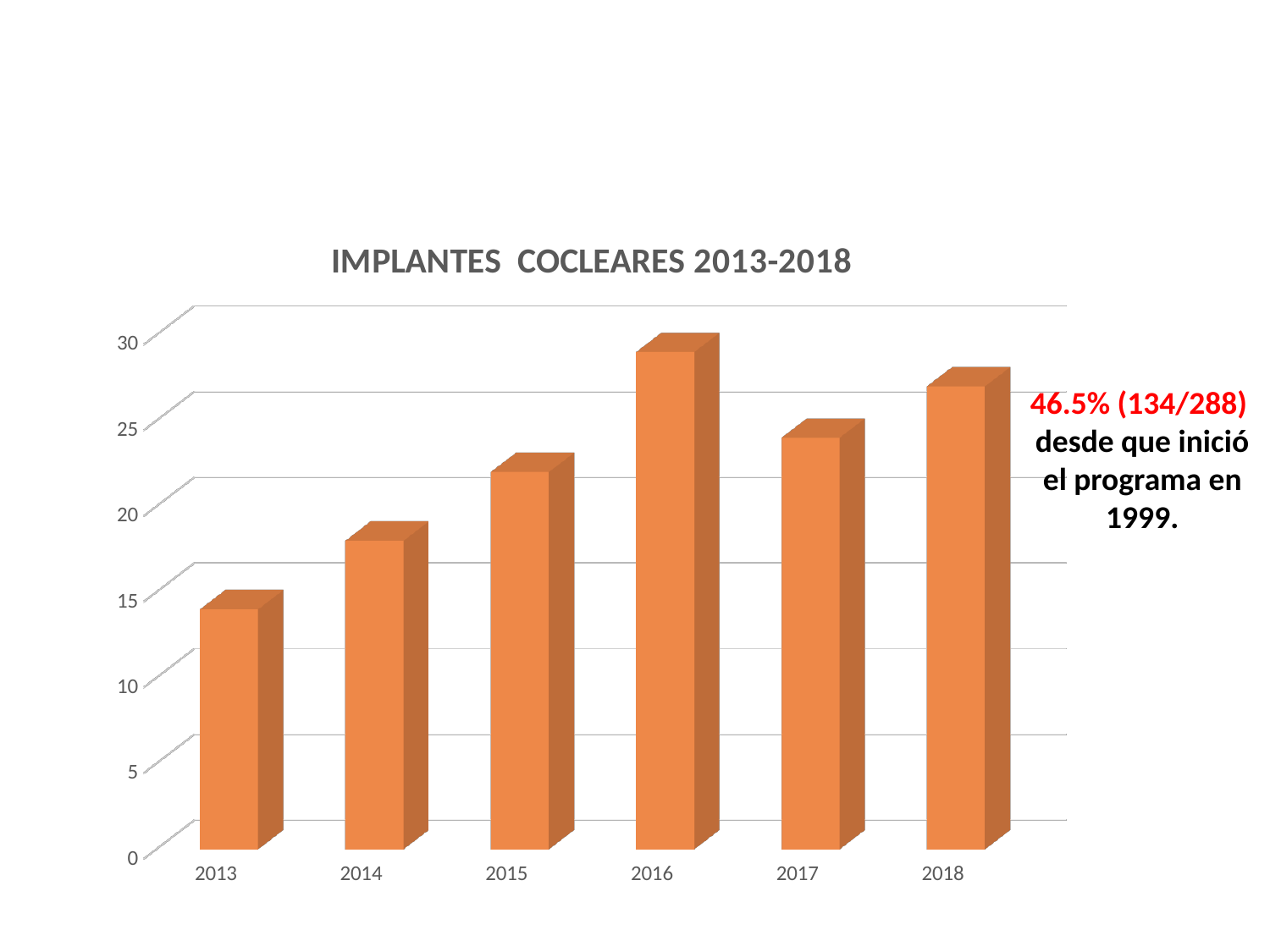
Is the value for 2018 greater or less than 25? greater What is the title of the chart? IMPLANTES COCLEARES 2013-2018 Is the value for 2016 greater or less than 25? greater Which year has the lowest bar in the chart? 2013 Which year has the larger value, 2017 or 2018? 2018 What kind of chart is shown on the slide? bar chart Is the value for 2014 greater or less than 20? less Do the values rise or fall from 2013 to 2016? rise Which year has the larger value, 2016 or 2017? 2016 How many years are shown on the x axis of the chart? 6 Which year has the highest bar in the chart? 2016